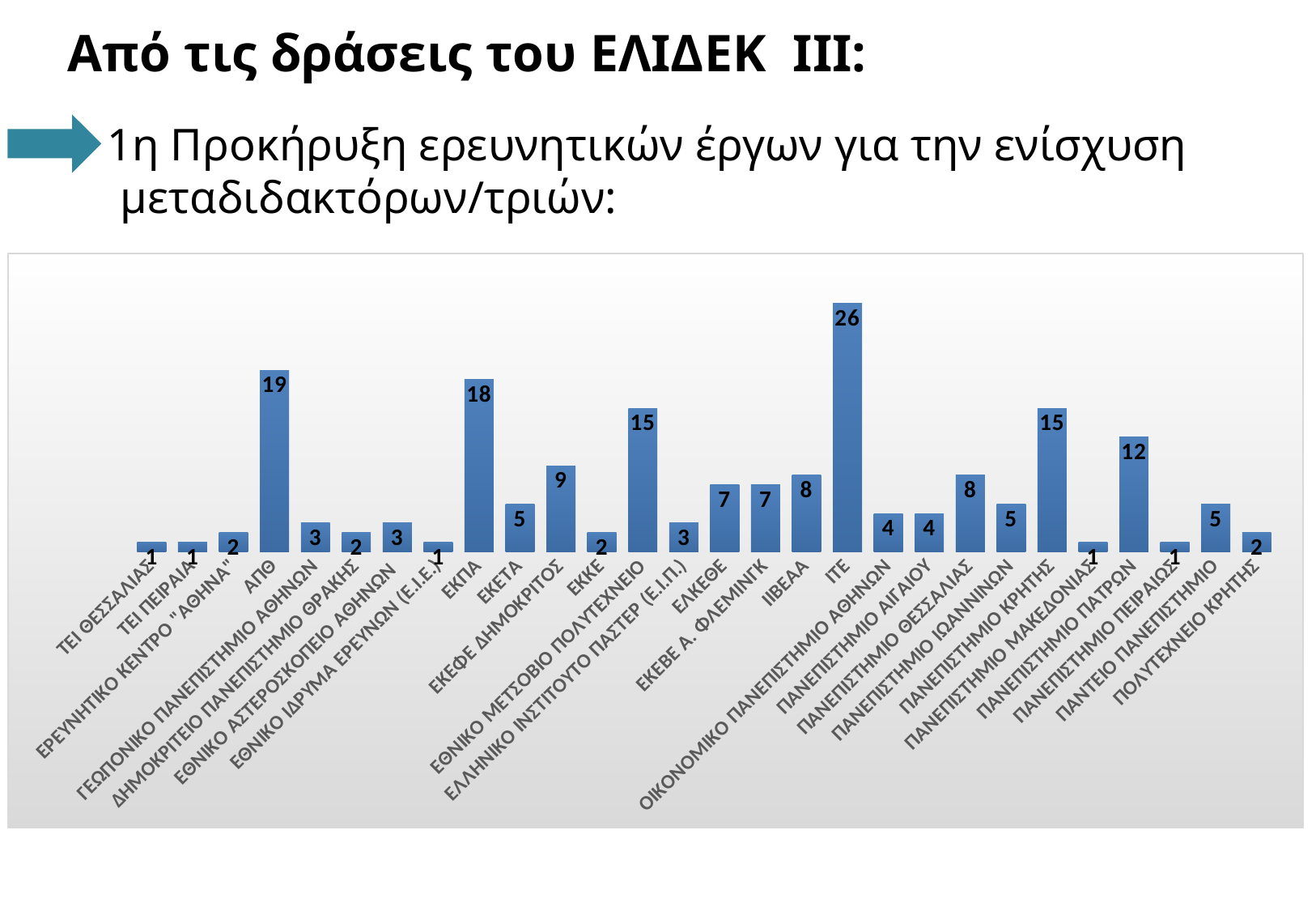
What is the value for ΙΤΕ? 26 What is the difference between the values for ΙΤΕ and ΑΠΘ? 7 Which is larger, the value for ΕΚΠΑ or the value for ΕΘΝΙΚΟ ΜΕΤΣΟΒΙΟ ΠΟΛΥΤΕΧΝΕΙΟ? ΕΚΠΑ What is the lowest value shown in the chart? 1 How many categories are shown in the chart? 28 What is the value for ΕΚΠΑ? 18 What is the value for ΠΑΝΕΠΙΣΤΗΜΙΟ ΠΑΤΡΩΝ? 12 What is the value for ΕΚΕΦΕ ΔΗΜΟΚΡΙΤΟΣ? 9 What is the value for ΑΠΘ? 19 Which is larger, the value for ΠΑΝΕΠΙΣΤΗΜΙΟ ΚΡΗΤΗΣ or the value for ΠΑΝΕΠΙΣΤΗΜΙΟ ΠΑΤΡΩΝ? ΠΑΝΕΠΙΣΤΗΜΙΟ ΚΡΗΤΗΣ What kind of chart is shown on the slide? Bar chart Which category has the highest value? ΙΤΕ